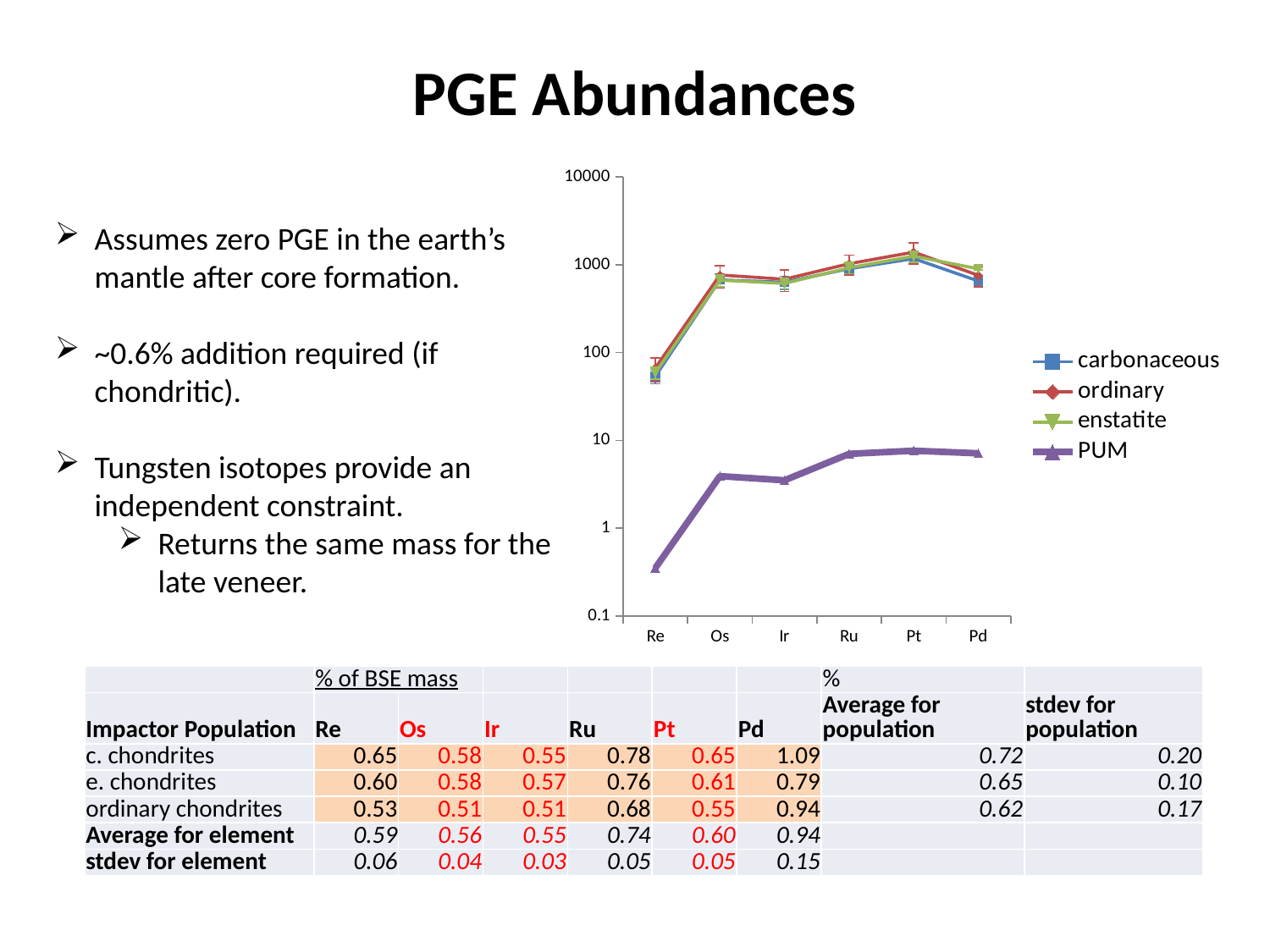
Is the ordinary value for Re greater or less than 100? less Which series in the chart legend is shown with a purple line? PUM How many elements are plotted along the x axis of the chart? 6 How many series does the chart legend list? 4 What kind of chart is shown on the slide? line chart Is the PUM value for Os greater or less than 10? less Is the PUM value for Re greater or less than 1? less Which is larger for the PUM series: the value for Re or the value for Os? Os Which series in the chart is plotted with the lowest values across all elements? PUM Do the values of the PUM series rise or fall from Re to Os? rise For which element does the PUM series reach its lowest value? Re